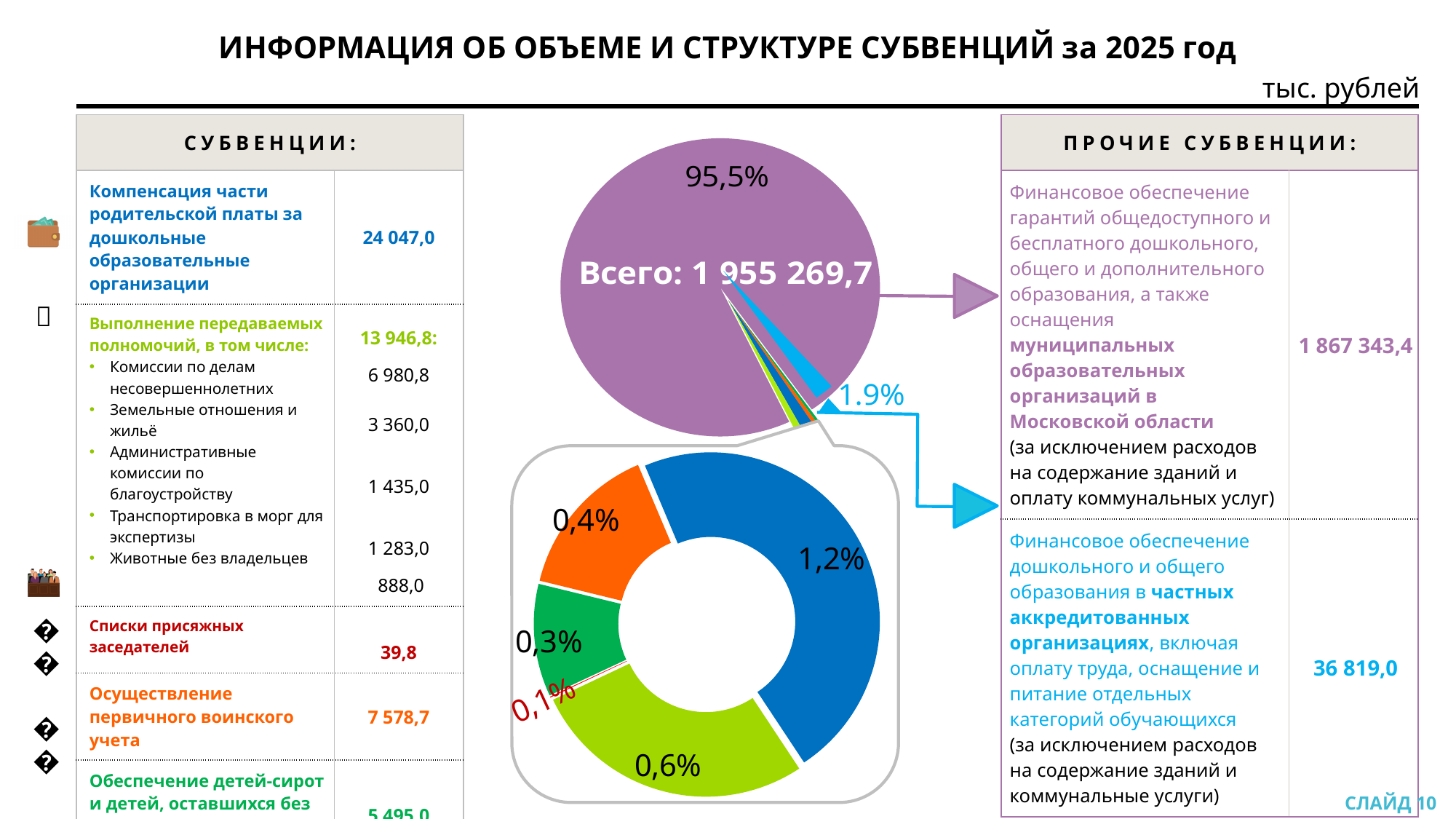
In the lower doughnut chart, what percentage is shown for the orange segment? 0,4% In the lower doughnut chart, what percentage is shown for the blue segment? 1,2% In the lower doughnut chart, which percentage label is the smallest? 0,1% In the upper pie chart, what percentage is shown for the largest (purple) slice? 95,5% In the lower doughnut chart, what percentage is shown for the light green segment? 0,6% In the upper pie chart, what total value is printed in the centre of the chart? Всего: 1 955 269,7 In the upper pie chart, what percentage is shown for the light blue slice? 1.9% In the upper pie chart, what is the difference between the 95,5% slice and the 1,9% slice? 93,6% What kind of chart is the lower chart on the slide (the one with a hole in the middle)? doughnut chart How many percentage labels are shown on the lower doughnut chart? 5 In the lower doughnut chart, which segment is larger: the orange one or the dark green one? the orange one (0,4%) What kind of chart is the upper chart on the slide (the one labelled 'Всего: 1 955 269,7')? pie chart